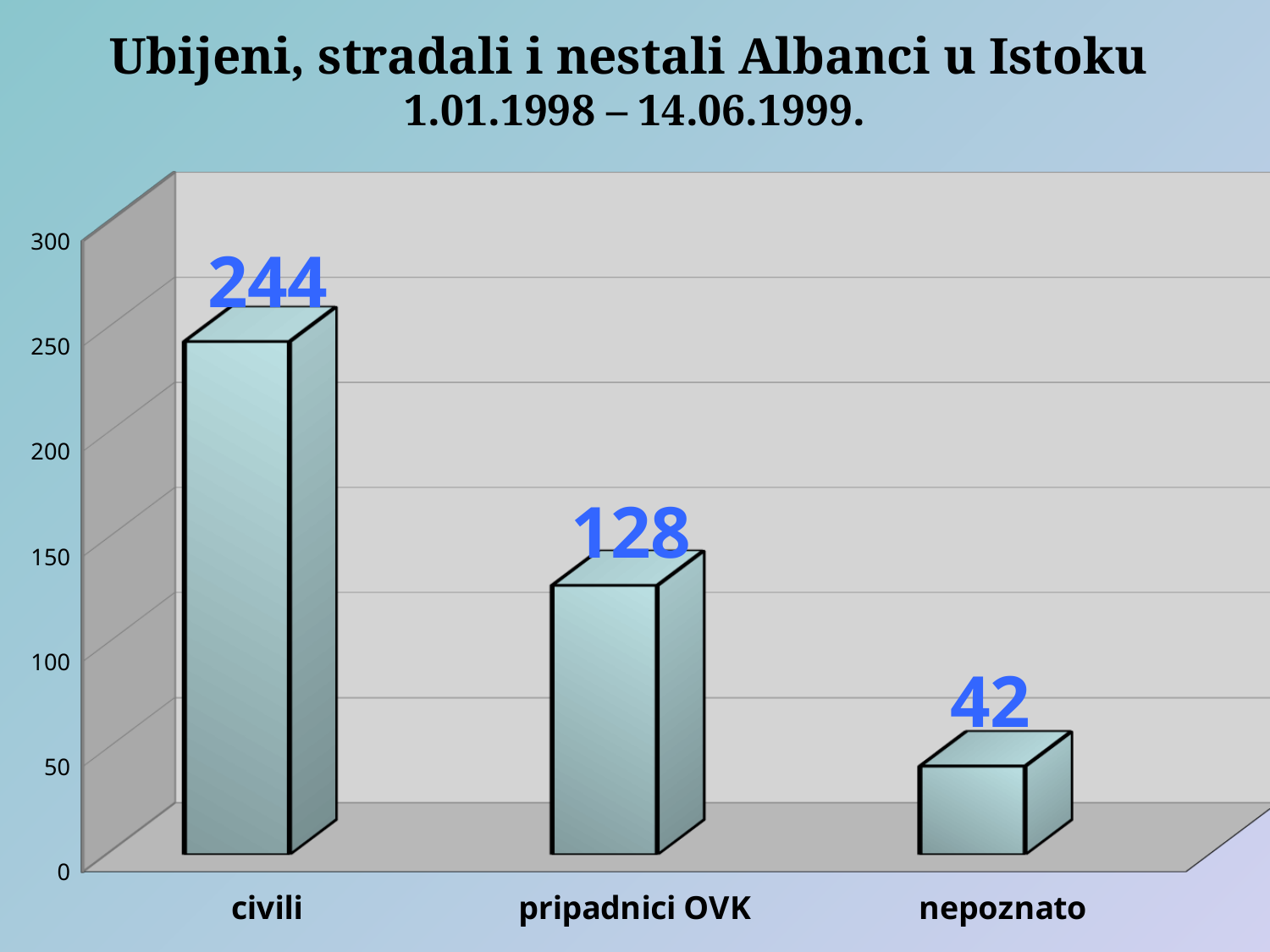
What is the value for civili? 244 Which category has the lowest value? nepoznato Which is larger, the value for pripadnici OVK or the value for nepoznato? pripadnici OVK What is the value for nepoznato? 42 What is the difference between the values for civili and pripadnici OVK? 116 What is the title of the chart? Ubijeni, stradali i nestali Albanci u Istoku 1.01.1998 – 14.06.1999. Is the value for civili greater or less than 200? greater Which category has the highest value? civili What kind of chart is shown on the slide? bar chart How many categories are shown on the x axis? 3 What is the difference between the values for pripadnici OVK and nepoznato? 86 What is the value for pripadnici OVK? 128